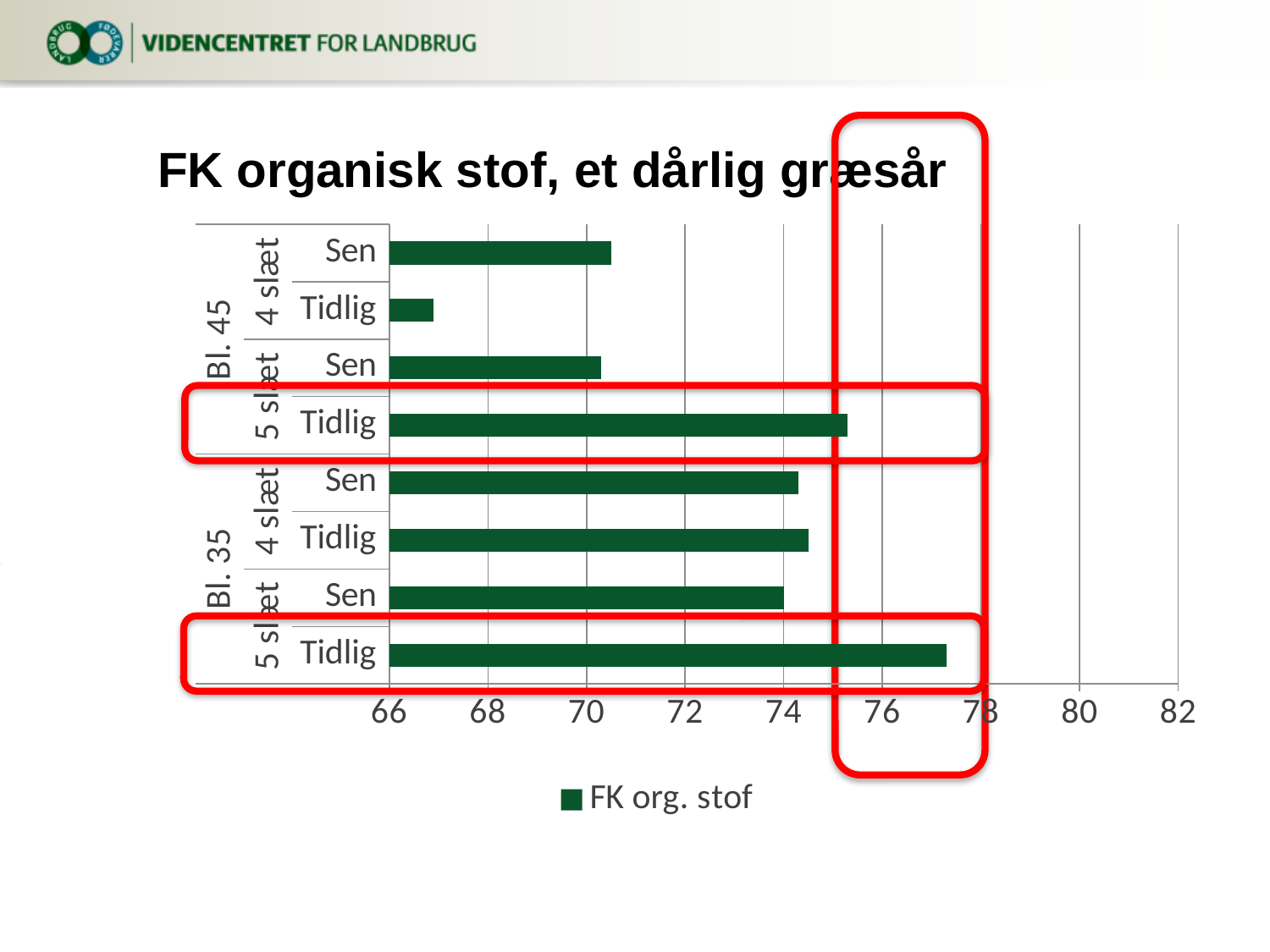
Is the value for Bl. 35, 5 slæt, Tidlig greater or less than 76? greater Within Bl. 45, 5 slæt, which is larger: Tidlig or Sen? Tidlig What is the title of the chart? FK organisk stof, et dårlig græsår Which bar has the lowest value? Bl. 45, 4 slæt, Tidlig What is the name of the series shown in the legend? FK org. stof How many series does the legend list? 1 Is the value for Bl. 45, 4 slæt, Tidlig greater or less than 68? less Which bar has the highest value? Bl. 35, 5 slæt, Tidlig Is the value for Bl. 45, 4 slæt, Sen greater or less than 72? less What kind of chart is shown on the slide? bar chart How many bars are plotted in the chart? 8